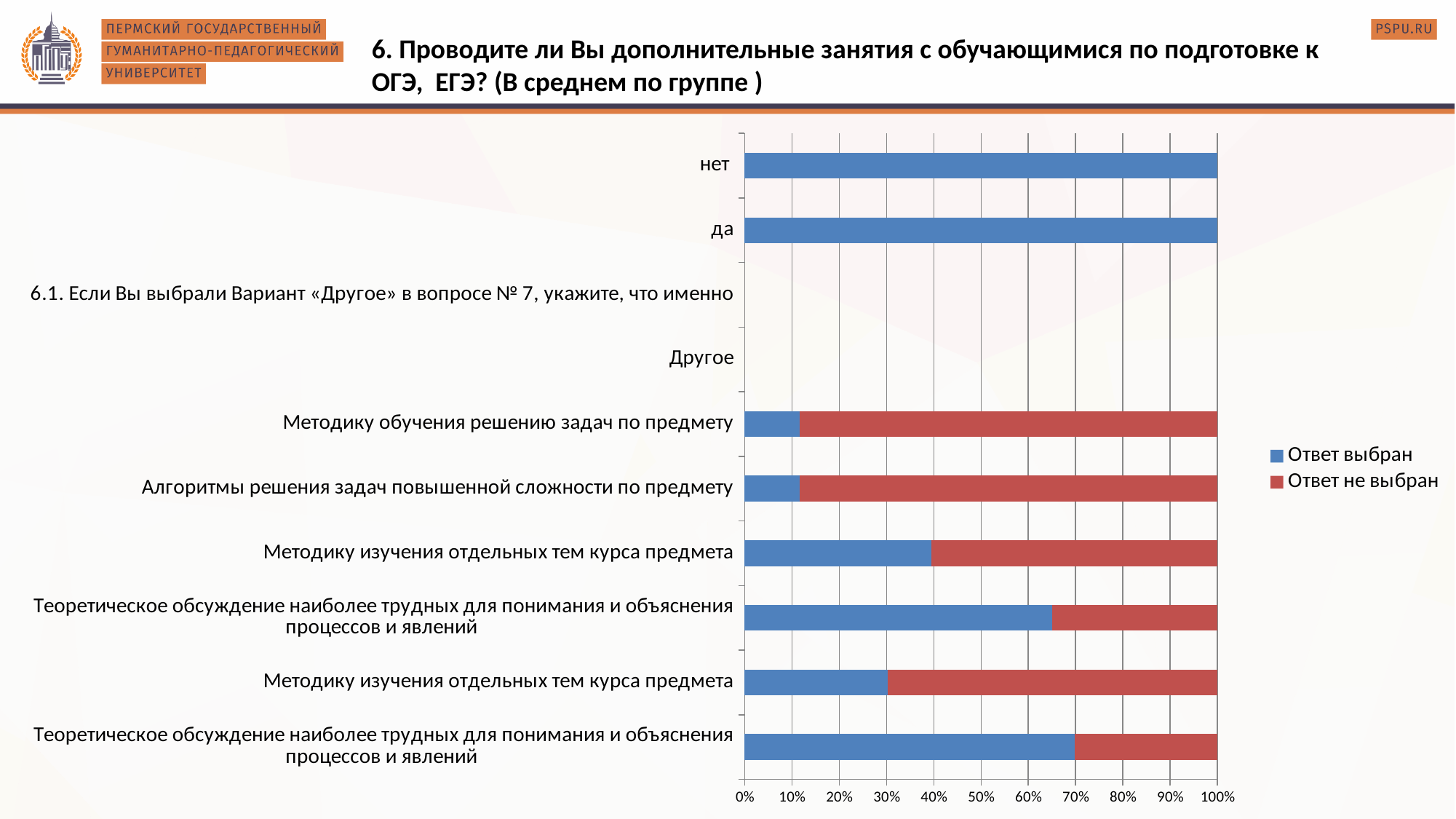
Which colour represents the series 'Ответ выбран'? blue How many series does the legend list? 2 Is the 'Ответ не выбран' value for 'Алгоритмы решения задач повышенной сложности по предмету' greater or less than 80%? greater Is the 'Ответ выбран' value for the lowest bar, 'Теоретическое обсуждение наиболее трудных для понимания и объяснения процессов и явлений', greater or less than 60%? greater Is the 'Ответ выбран' value for 'Методику обучения решению задач по предмету' greater or less than 20%? less Which has a larger 'Ответ выбран' share: 'Алгоритмы решения задач повышенной сложности по предмету' or 'Методику изучения отдельных тем курса предмета'? Методику изучения отдельных тем курса предмета How many categories are listed on the vertical axis of the chart? 10 What are the two legend entries of the chart? Ответ выбран, Ответ не выбран What is the value of 'Ответ выбран' for the category 'да'? 100% What kind of chart is shown on the slide? bar chart What is the value of 'Ответ выбран' for the category 'нет'? 100%